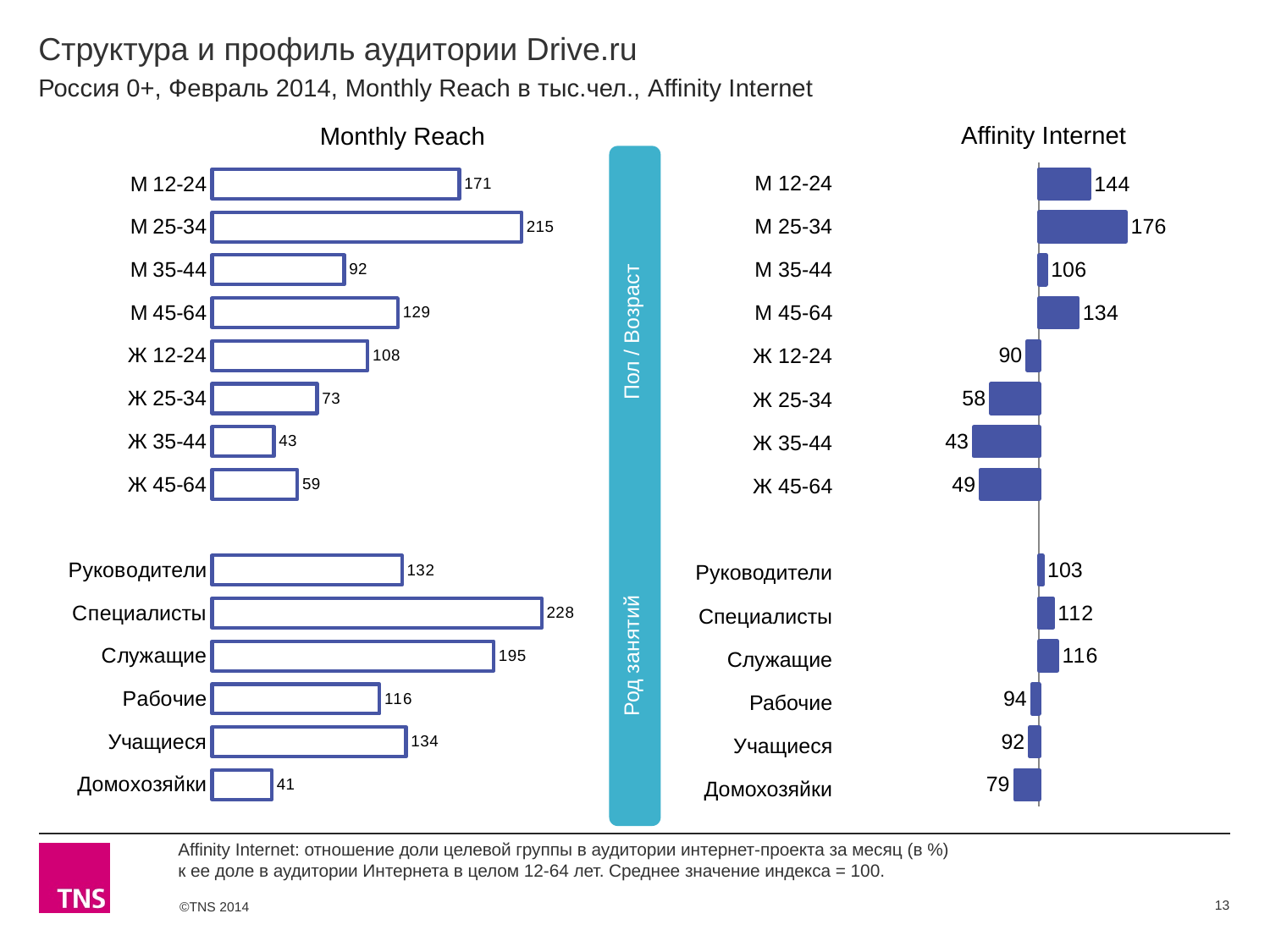
In the Affinity Internet chart, which category has the lowest value? Ж 35-44 In the Affinity Internet chart, which is larger, the value for Служащие or the value for Руководители? Служащие In the Monthly Reach chart, what is the value for Учащиеся? 134 In the Monthly Reach chart, which category has the highest value? Специалисты How many categories are plotted in the Monthly Reach chart? 14 In the Affinity Internet chart, which category has the highest value? М 25-34 In the Monthly Reach chart, what is the value for М 25-34? 215 In the Affinity Internet chart, what is the value for Ж 35-44? 43 In the Affinity Internet chart, what is the difference between М 12-24 and Ж 12-24? 54 In the Monthly Reach chart, which category has the lowest value? Домохозяйки In the Monthly Reach chart, what is the difference between Служащие and Рабочие? 79 What kind of chart is the Affinity Internet chart? Bar chart